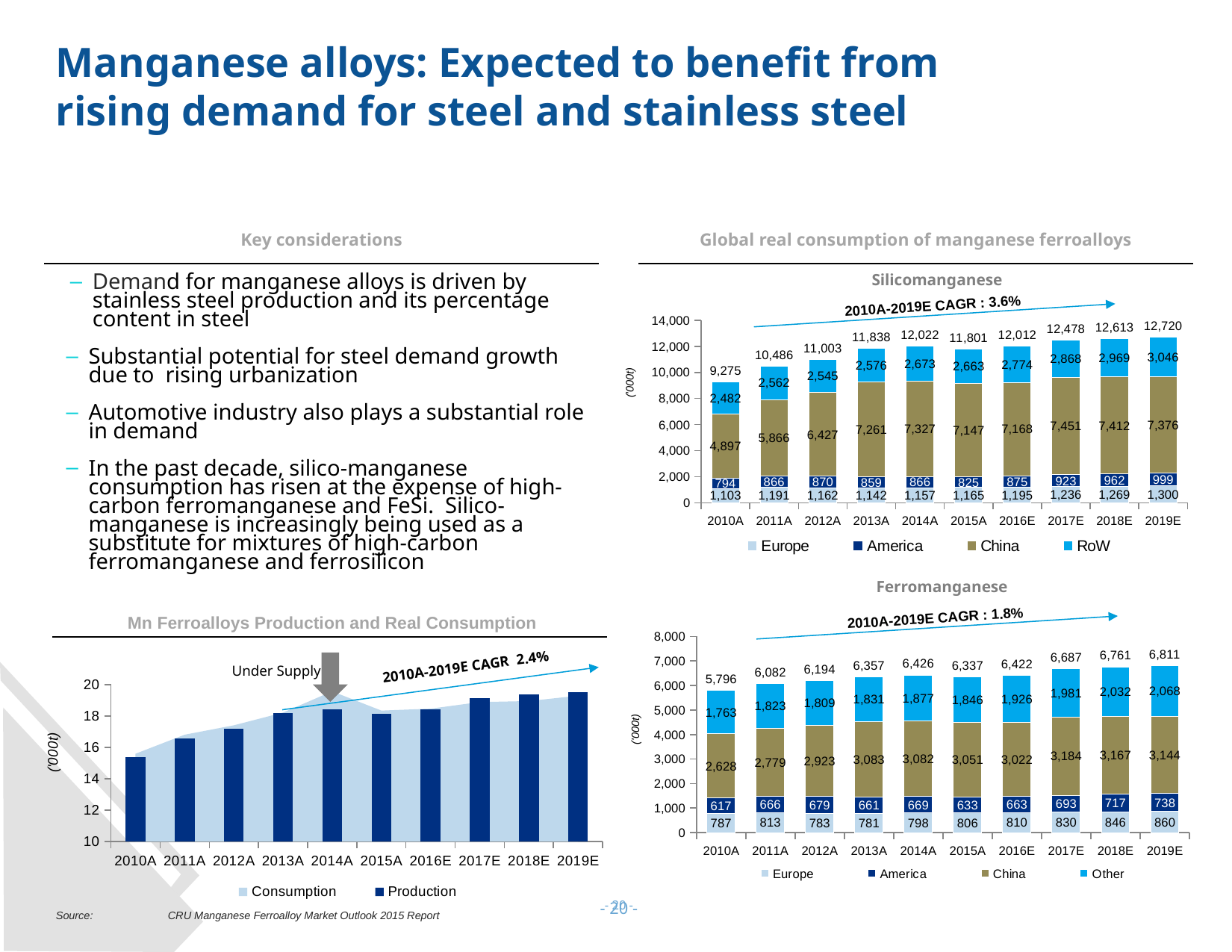
How many series does the legend of the Ferromanganese chart list? 4 In the Ferromanganese chart, what is the value for Other in 2019E? 2,068 In the Ferromanganese chart, which year has the lowest total consumption? 2010A In the Silicomanganese chart, what CAGR is shown for 2010A-2019E? 3.6% In the Silicomanganese chart, which year has the highest total consumption? 2019E In the Silicomanganese chart, what is the value for China in 2010A? 4,897 In the Mn Ferroalloys Production and Real Consumption chart, is the Production value for 2010A greater or less than 16? less In the Silicomanganese chart, what is the difference between the total for 2019E and the total for 2010A? 3,445 How many years are shown on the x axis of the Mn Ferroalloys Production and Real Consumption chart? 10 In the Ferromanganese chart, what is the difference between the China value in 2019E and the China value in 2010A? 516 In the Ferromanganese chart, which is larger in 2019E: China or Other? China In the Silicomanganese chart, what is the total consumption shown for 2019E? 12,720